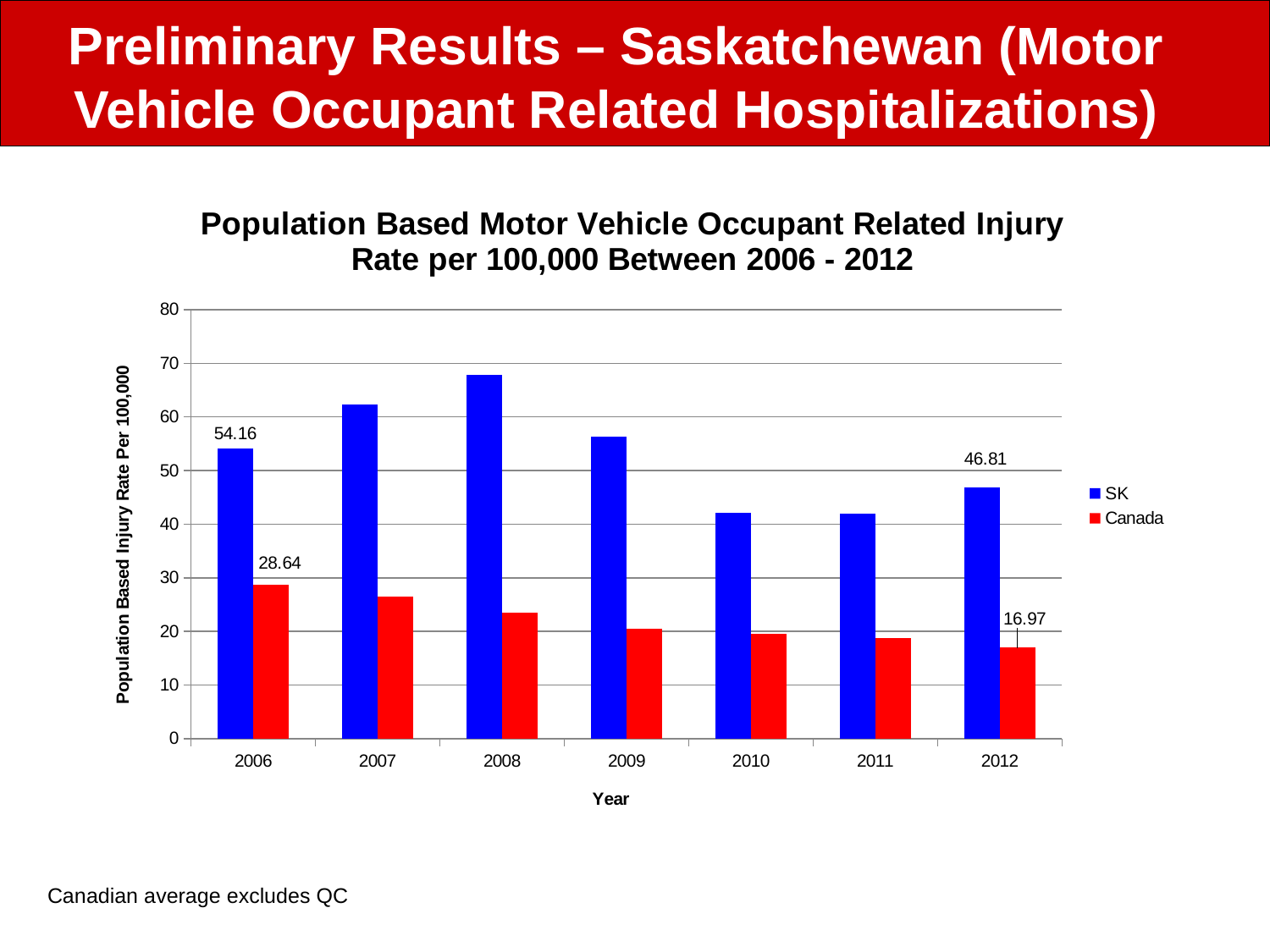
What is the Canada value for 2006? 28.64 Does the Canada value generally rise or fall from 2006 to 2012? fall What is the difference between the SK and Canada values in 2006? 25.52 By how much did the SK value fall from 2006 to 2012? 7.35 Is the SK value for 2010 greater or less than 50? less What is the SK value for 2006? 54.16 Is the SK value for 2008 greater or less than 60? greater Which is larger, the SK value for 2007 or the SK value for 2009? 2007 What is the Canada value for 2012? 16.97 In which year is the Canada value lowest? 2012 In which year is the SK value highest? 2008 How many years are shown on the x axis? 7